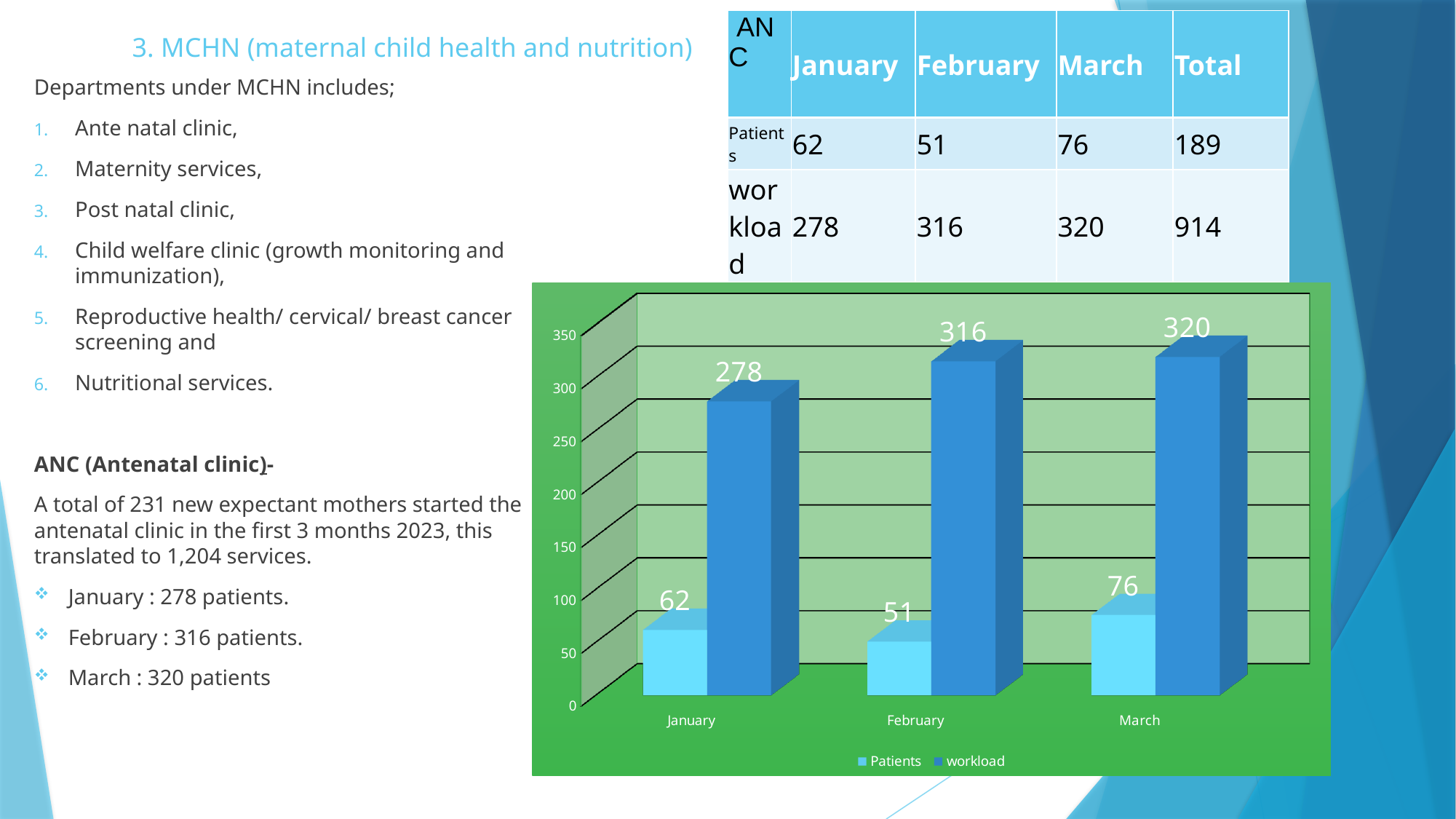
Is the Patients value for January larger or smaller than the Patients value for February? larger Does the workload rise or fall from January to March in the chart? rise What is the workload value for February in the chart? 316 Which month has the highest workload in the chart? March What is the Patients value for March in the chart? 76 What is the difference between the workload for March and the workload for January? 42 How many series does the chart legend list? 2 What are the two series named in the chart legend? Patients and workload Which month has the lowest Patients value in the chart? February What is the Patients value for January in the chart? 62 How many months are shown on the x axis of the chart? 3 What kind of chart is shown on the slide? bar chart